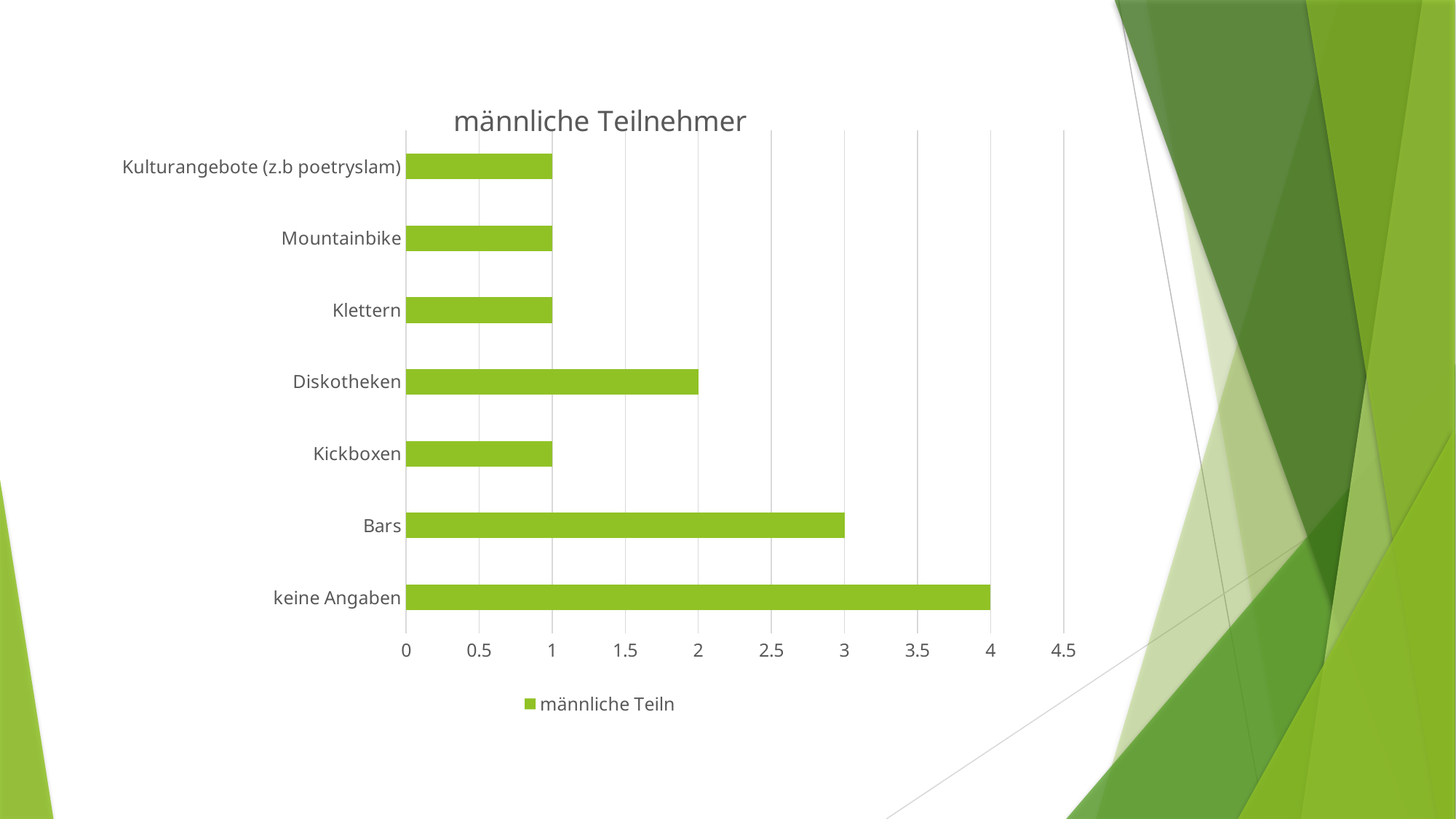
Which is larger, the value for Diskotheken or the value for Kickboxen? Diskotheken How many categories are shown in the chart? 7 What is the value for keine Angaben? 4 What is the value for Bars? 3 What is the difference between the values for keine Angaben and Bars? 1 What kind of chart is shown on the slide? bar chart What is the value for Diskotheken? 2 Is the value for Bars greater or less than 2.5? greater What is the difference between the values for Bars and Diskotheken? 1 How many series does the legend list? 1 What is the value for Klettern? 1 Which category has the highest value? keine Angaben